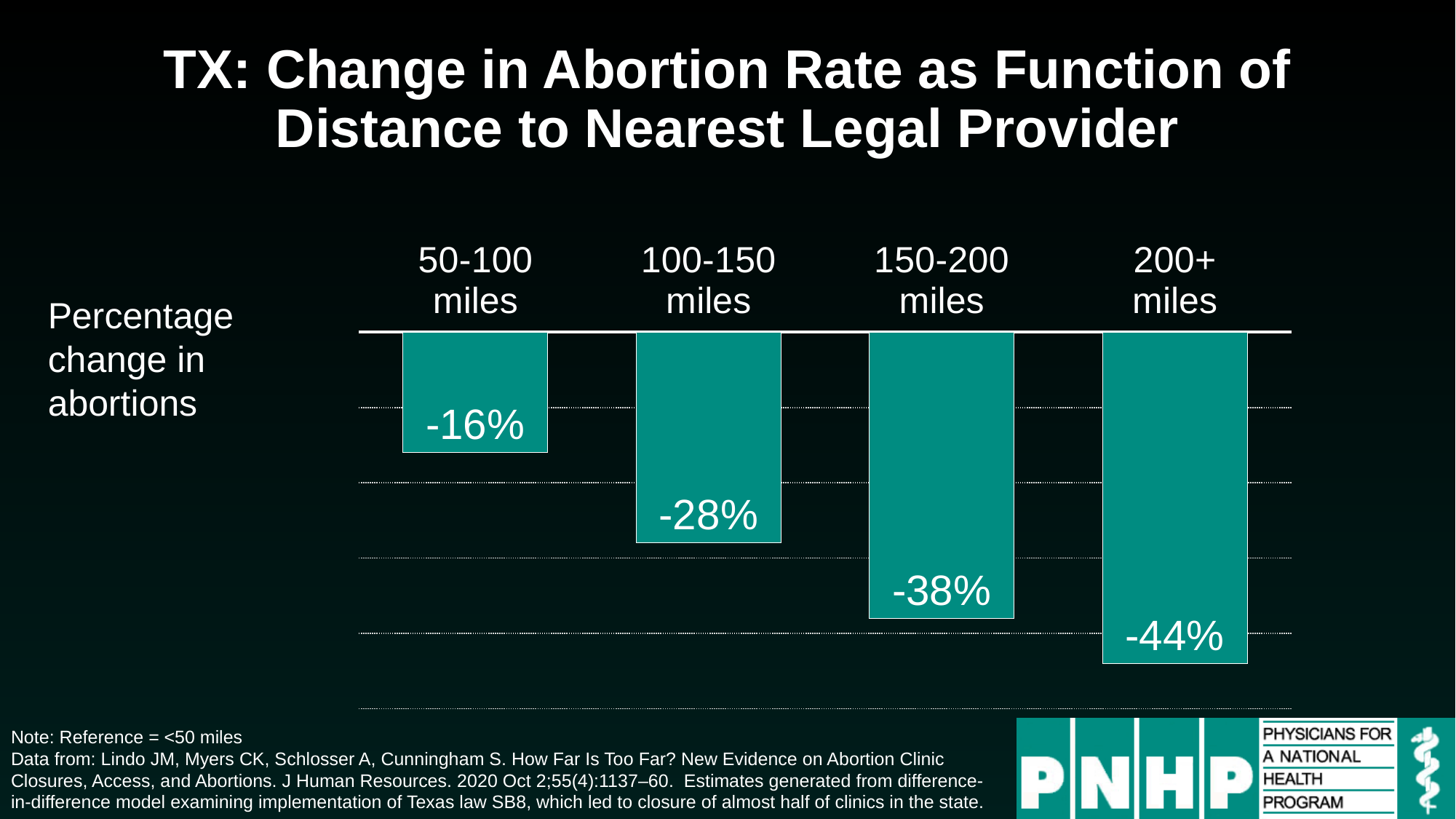
Which distance category shows the largest decline in abortions? 200+ miles How does the percentage change in abortions trend as distance to the nearest legal provider increases? It declines further (becomes more negative) Which distance category shows the smallest decline in abortions? 50-100 miles What is the difference in percentage points between the 200+ miles and 50-100 miles categories? 28 percentage points Which category shows a larger decline in abortions: 100-150 miles or 150-200 miles? 150-200 miles What is the percentage change in abortions for the 50-100 miles category? -16% What is the percentage change in abortions for the 150-200 miles category? -38% How many distance categories are shown in the chart? 4 What is the reference distance category noted on the slide? <50 miles What type of chart is shown on the slide? Bar chart What is the percentage change in abortions for the 100-150 miles category? -28% What is the percentage change in abortions for the 200+ miles category? -44%